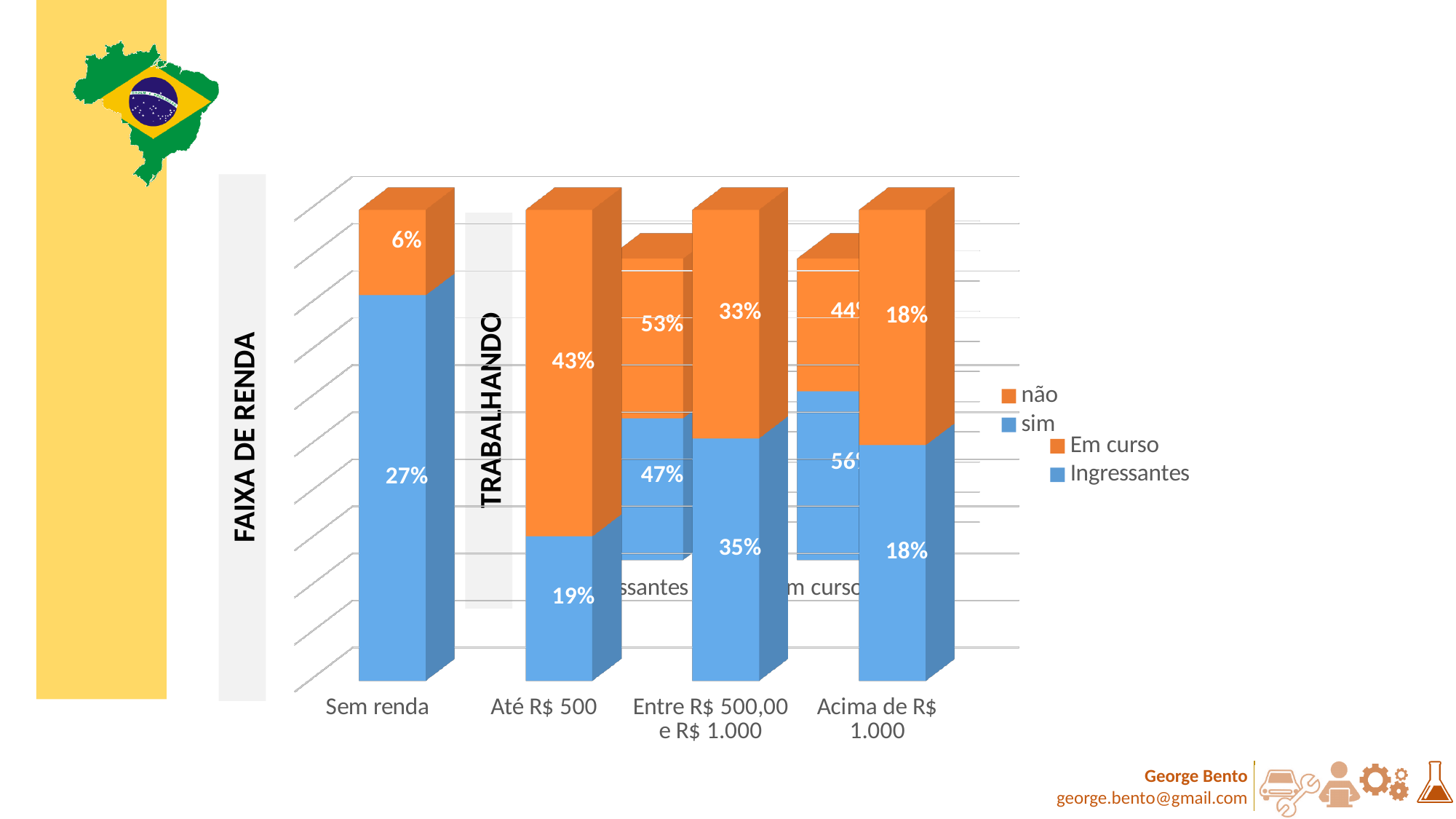
In the FAIXA DE RENDA chart, which is larger for Sem renda: Ingressantes or Em curso? Ingressantes In the TRABALHANDO chart, what is the 'não' value for Ingressantes? 53% In the FAIXA DE RENDA chart, which income category has the lowest Em curso value? Sem renda In the FAIXA DE RENDA chart, what is the difference between the Em curso and Ingressantes values for Até R$ 500? 24% What kind of chart is the FAIXA DE RENDA chart? Stacked bar chart In the FAIXA DE RENDA chart, what is the Ingressantes value for Sem renda? 27% How many income categories are shown on the x axis of the FAIXA DE RENDA chart? 4 In the FAIXA DE RENDA chart, what is the Ingressantes value for Entre R$ 500,00 e R$ 1.000? 35% In the FAIXA DE RENDA chart, what is the Em curso value for Até R$ 500? 43% In the FAIXA DE RENDA chart, which income category has the highest Ingressantes value? Entre R$ 500,00 e R$ 1.000 In the FAIXA DE RENDA chart, what is the Em curso value for Acima de R$ 1.000? 18% In the FAIXA DE RENDA chart, what is the total of the stacked bar for Entre R$ 500,00 e R$ 1.000? 68%